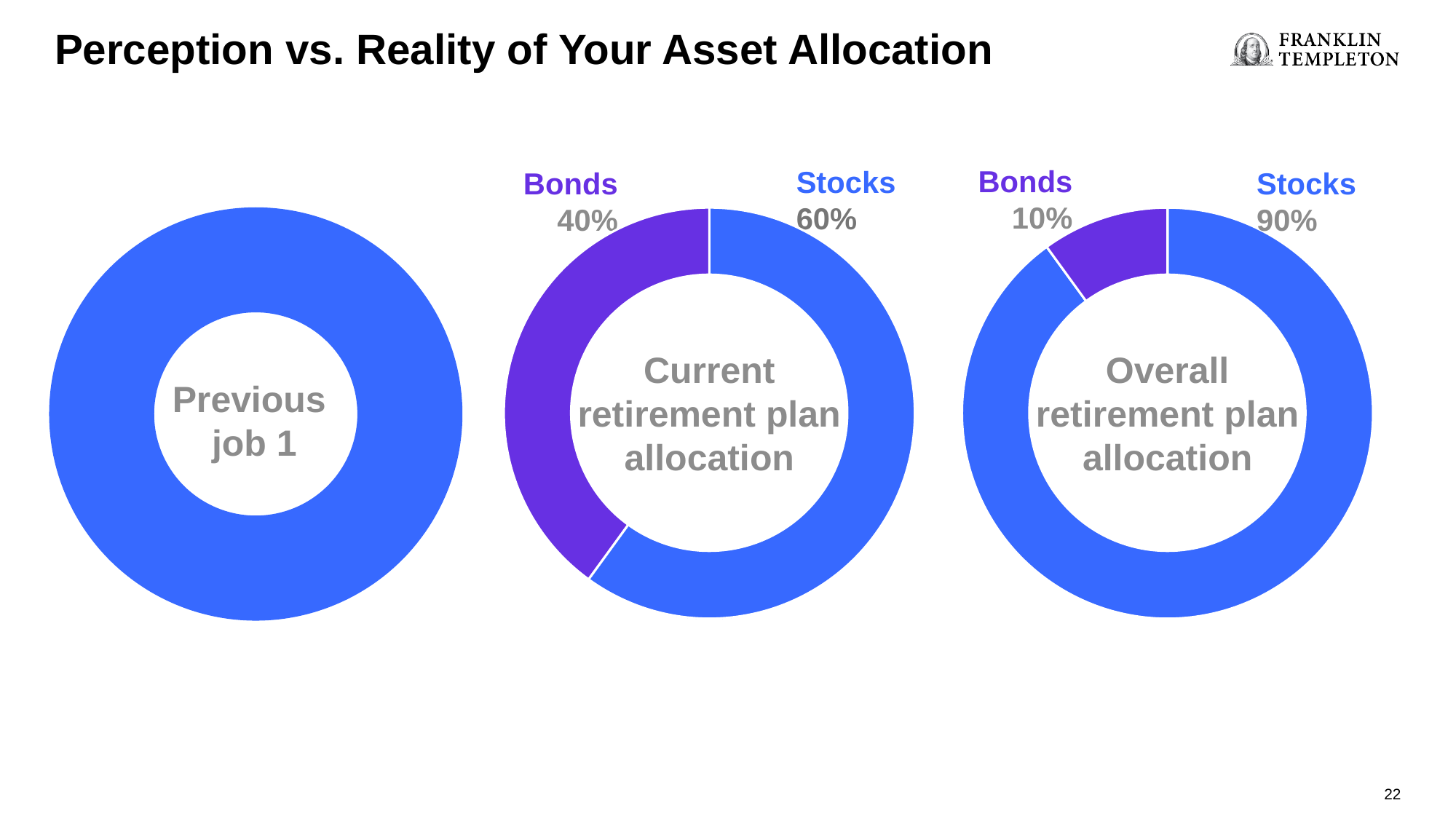
In the 'Overall retirement plan allocation' chart, what is the difference between the Stocks share and the Bonds share? 80% What colour represents Bonds in the 'Current retirement plan allocation' chart? Purple How many categories are shown in the 'Current retirement plan allocation' chart? 2 In the 'Overall retirement plan allocation' chart, what share is allocated to Stocks? 90% In the 'Current retirement plan allocation' chart, which category has the larger share? Stocks In the 'Overall retirement plan allocation' chart, which category has the smaller share? Bonds Is the Bonds share larger in the 'Current retirement plan allocation' chart or the 'Overall retirement plan allocation' chart? Current retirement plan allocation What kind of chart is the 'Overall retirement plan allocation' chart? Doughnut chart In the 'Current retirement plan allocation' chart, what is the difference between the Stocks share and the Bonds share? 20% In the 'Overall retirement plan allocation' chart, what share is allocated to Bonds? 10% In the 'Current retirement plan allocation' chart, what share is allocated to Stocks? 60% In the 'Current retirement plan allocation' chart, what share is allocated to Bonds? 40%